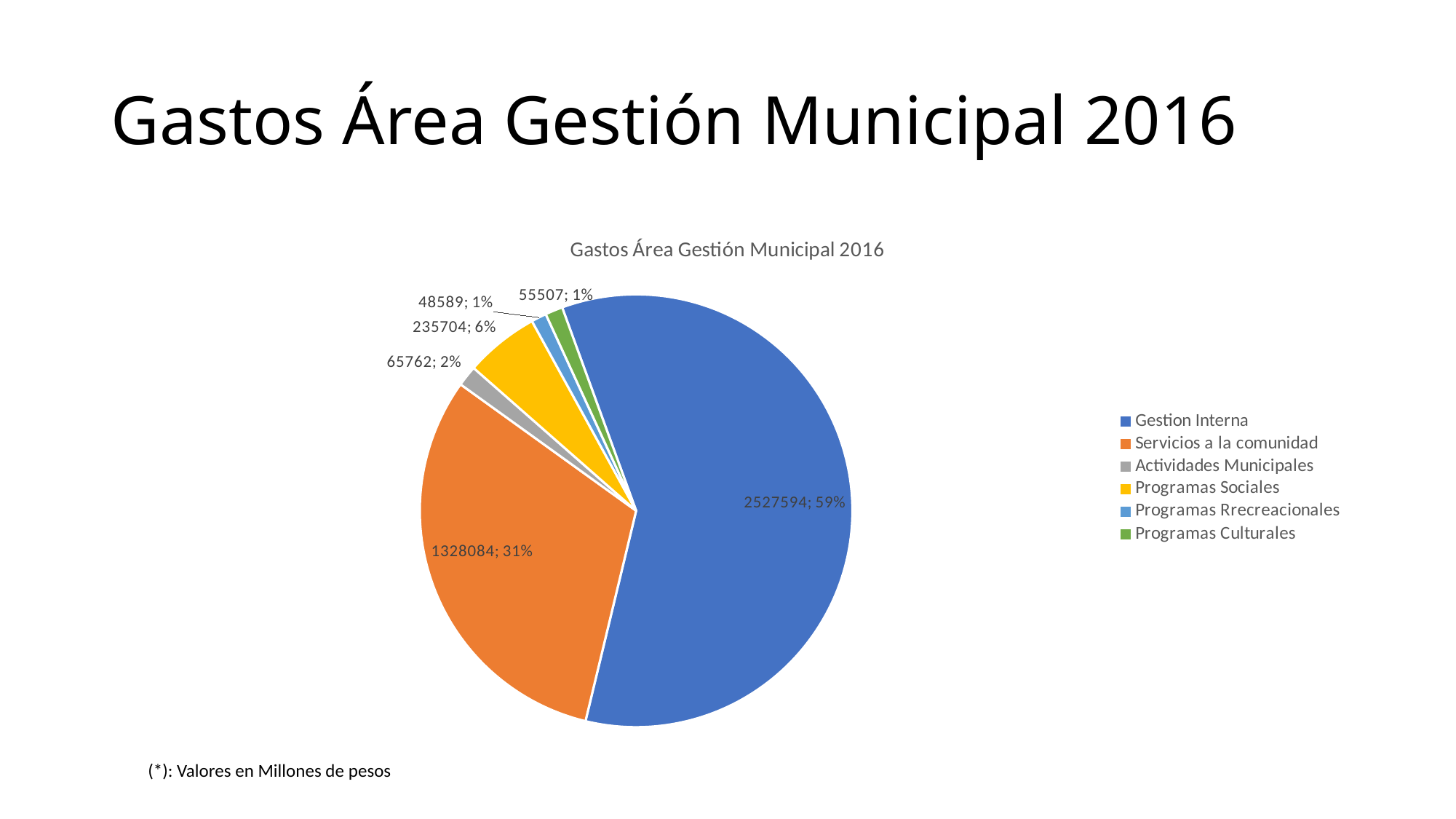
How many categories does the legend list? 6 Which category has the smallest value? Programas Rrecreacionales What share of the pie does Servicios a la comunidad represent? 31% What share of the pie does Gestion Interna represent? 59% What is the value for Programas Sociales? 235704 What is the value for Servicios a la comunidad? 1328084 Which category has the largest slice? Gestion Interna What is the difference between the values for Gestion Interna and Servicios a la comunidad? 1199510 What kind of chart is shown on the slide? Pie chart What is the value for Gestion Interna? 2527594 Which is larger, the value for Programas Culturales or Programas Rrecreacionales? Programas Culturales What is the value for Actividades Municipales? 65762